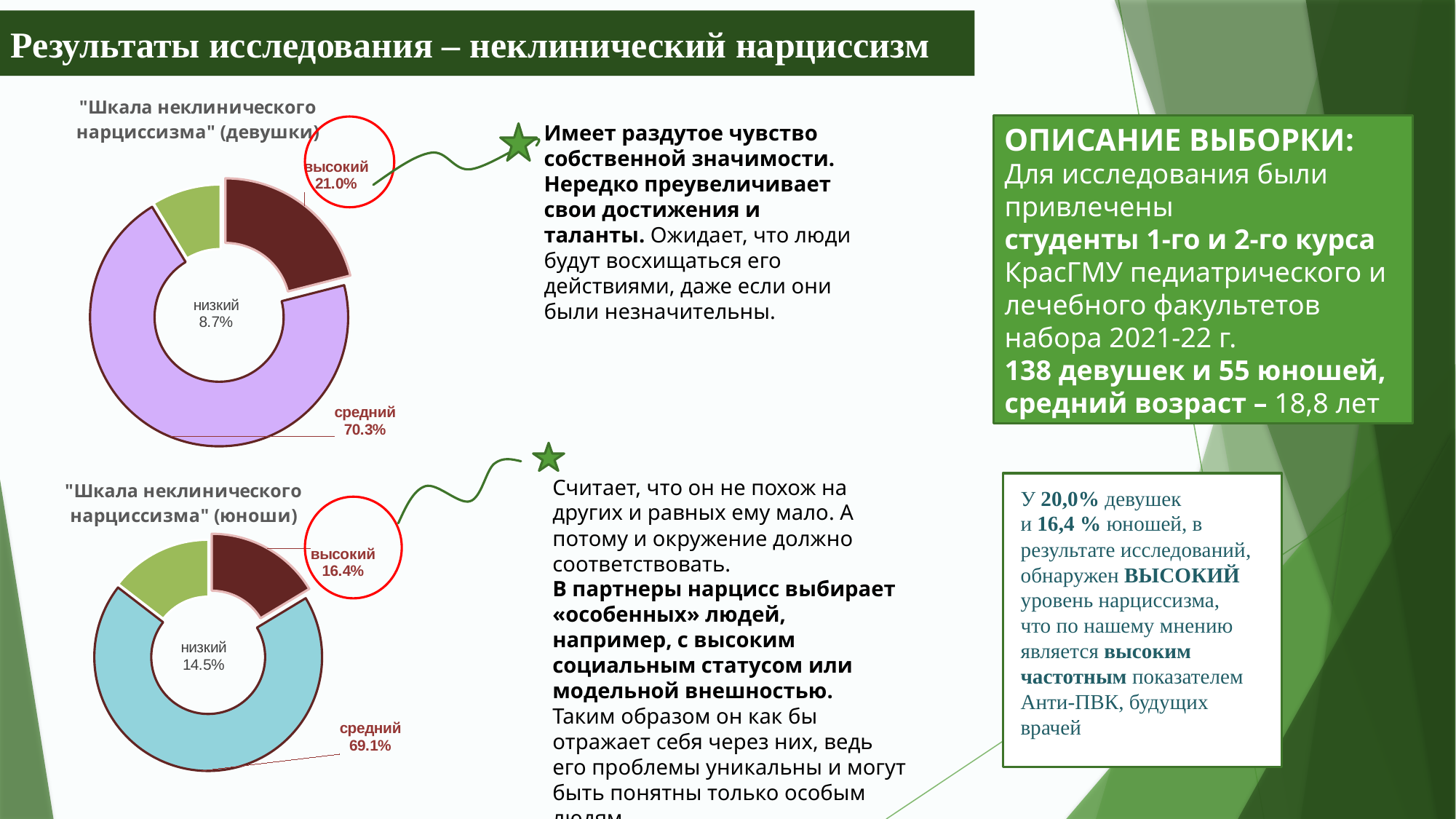
In the bottom chart "Шкала неклинического нарциссизма" (юноши), which category has the largest share? средний In the bottom chart "Шкала неклинического нарциссизма" (юноши), what is the value for the "высокий" category? 16.4% In the top chart "Шкала неклинического нарциссизма" (девушки), what is the value for the "высокий" category? 21.0% Which is larger: the "высокий" share in the top chart (девушки) or the "высокий" share in the bottom chart (юноши)? девушки (21.0%) What is the difference between the "средний" value in the top chart (девушки) and the "средний" value in the bottom chart (юноши)? 1.2% How many categories does the bottom chart "Шкала неклинического нарциссизма" (юноши) show? 3 In the top chart "Шкала неклинического нарциссизма" (девушки), which category has the smallest share? низкий In the bottom chart "Шкала неклинического нарциссизма" (юноши), what is the value for the "низкий" category? 14.5% What type of chart is the top chart "Шкала неклинического нарциссизма" (девушки)? Doughnut (pie) chart In the top chart "Шкала неклинического нарциссизма" (девушки), what is the value for the "низкий" category? 8.7% In the top chart "Шкала неклинического нарциссизма" (девушки), what is the value for the "средний" category? 70.3% In the top chart "Шкала неклинического нарциссизма" (девушки), what is the difference between the "высокий" and "низкий" values? 12.3%